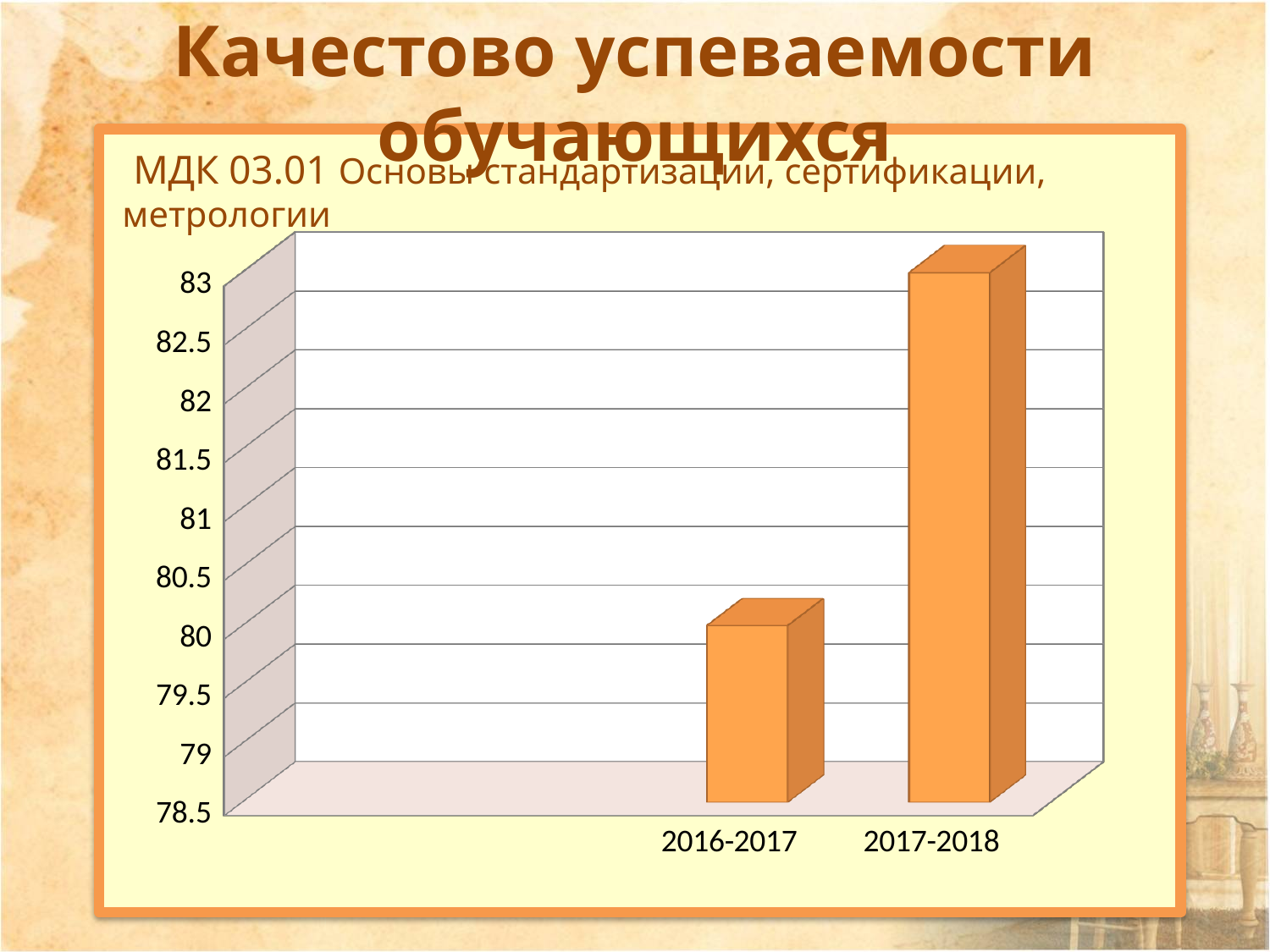
Is the value for 2016-2017 greater or less than 79? greater Which category has the lowest value on the chart? 2016-2017 Which is larger, the value for 2016-2017 or the value for 2017-2018? 2017-2018 Is the value for 2016-2017 greater or less than 81? less What kind of chart is shown on the slide? bar chart How many categories are plotted on the chart? 2 Is the value for 2017-2018 greater or less than 82? greater Which category has the highest value on the chart? 2017-2018 Do the values rise or fall from 2016-2017 to 2017-2018? rise What is the title of the chart? МДК 03.01 Основы стандартизации, сертификации, метрологии What is the lowest value shown on the vertical axis of the chart? 78.5